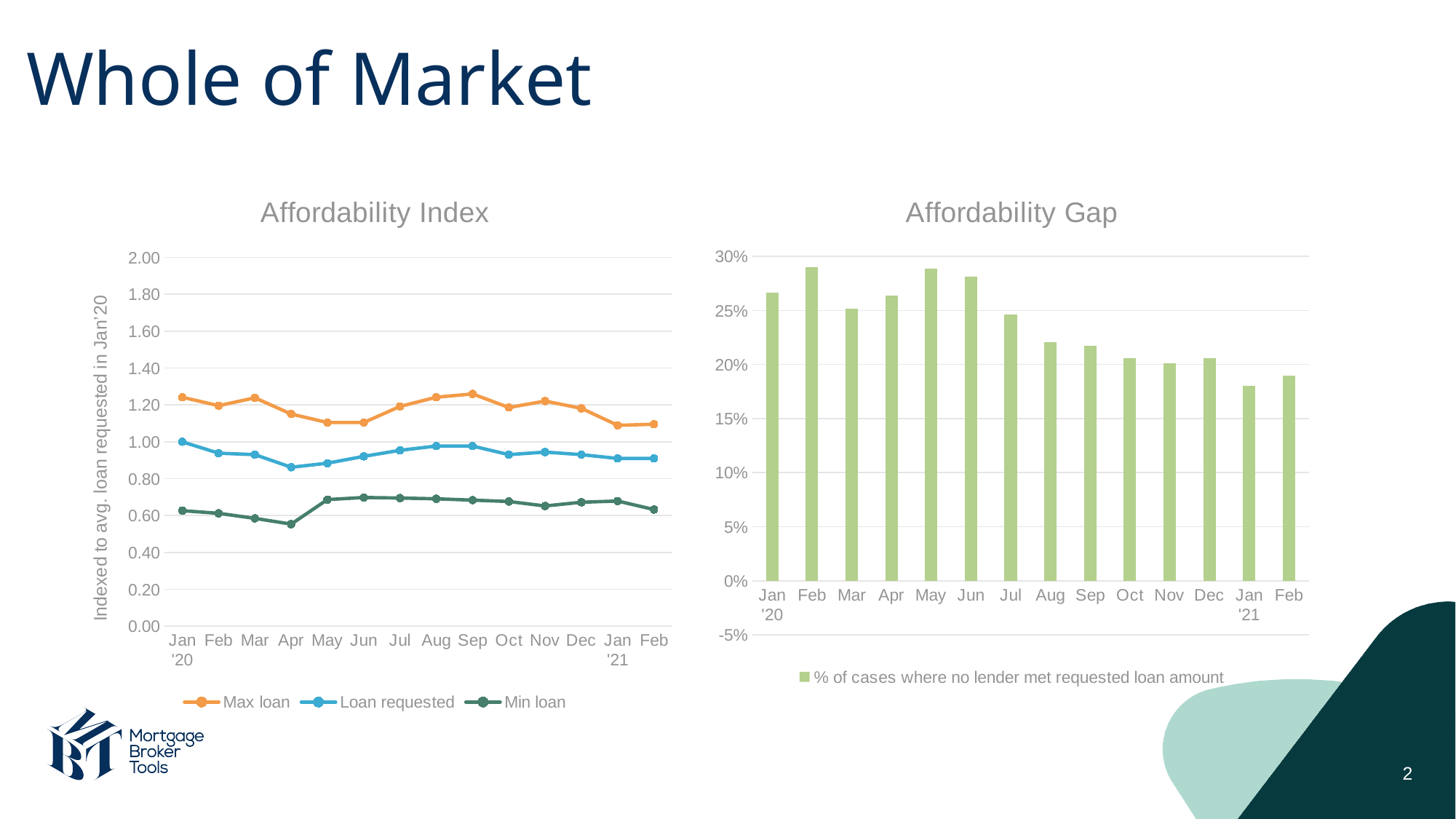
In the Affordability Index chart, is the Max loan value for Sep greater or less than 1.20? greater In the Affordability Index chart, which series is higher in Jun: Max loan or Min loan? Max loan How many bars are plotted in the Affordability Gap chart? 14 In the Affordability Gap chart, is the value for Jan '20 greater or less than 25%? greater In the Affordability Gap chart, is the value for Jan '21 greater or less than 20%? less What is the legend entry of the Affordability Gap chart? % of cases where no lender met requested loan amount What kind of chart is the Affordability Index chart? line chart What kind of chart is the Affordability Gap chart? bar chart How many series does the legend of the Affordability Index chart list? 3 In the Affordability Gap chart, do the values generally rise or fall from Jan '20 to Feb '21? fall In the Affordability Index chart, what is the value of Loan requested in Jan '20? 1.00